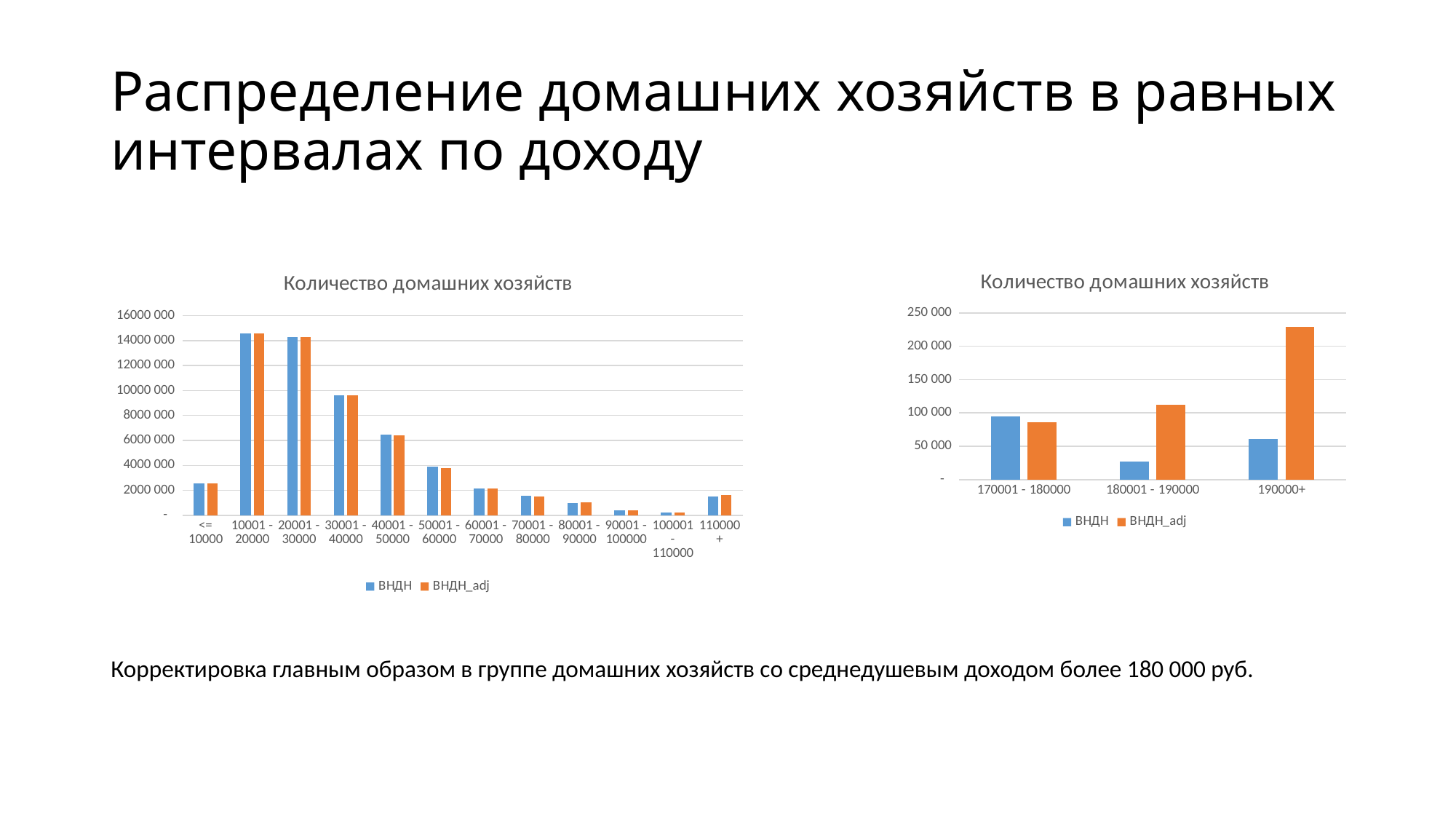
In the left chart, do the ВНДН values generally rise or fall from 10001 - 20000 to 100001 - 110000? fall What kind of chart is the chart on the left of the slide? bar chart In the right chart, for the category 180001 - 190000, which series has the larger value, ВНДН or ВНДН_adj? ВНДН_adj In the left chart, is the ВНДН value for 30001 - 40000 greater or less than 8000 000? greater In the right chart, which category has the highest ВНДН_adj value? 190000+ In the left chart, is the ВНДН_adj value for 40001 - 50000 greater or less than 8000 000? less How many income categories are shown on the x axis of the left chart? 12 In the left chart, is the ВНДН value for <= 10000 greater or less than 2000 000? greater In the left chart, which income category has the lowest ВНДН value? 100001 - 110000 How many series does the legend of the left chart list? 2 How many income categories are shown in the right chart? 3